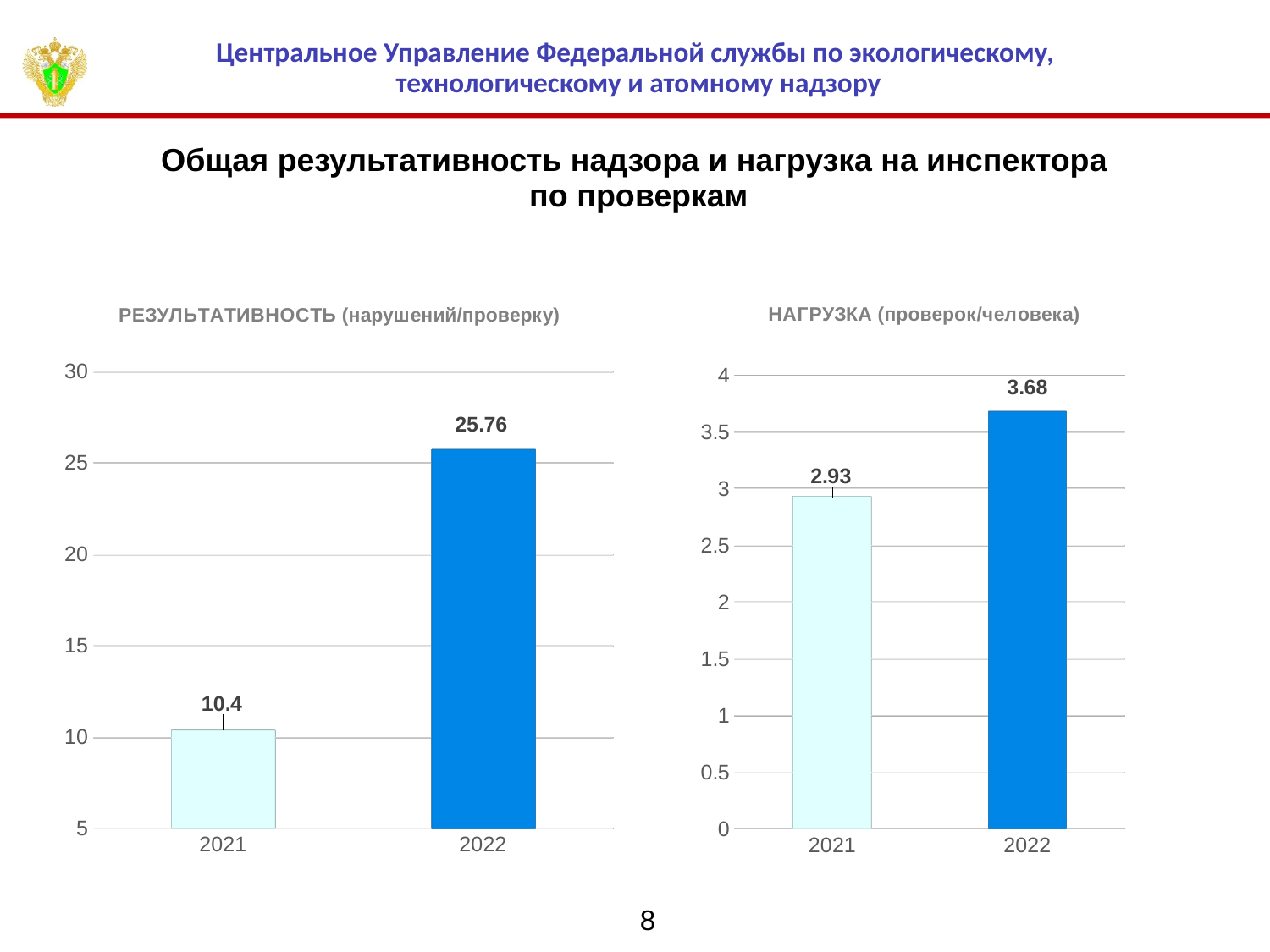
How many categories are shown in the НАГРУЗКА (проверок/человека) chart? 2 In the НАГРУЗКА (проверок/человека) chart, which is larger, the value for 2021 or 2022? 2022 In the РЕЗУЛЬТАТИВНОСТЬ (нарушений/проверку) chart, what is the difference between the 2022 and 2021 values? 15.36 In the НАГРУЗКА (проверок/человека) chart, what is the value for 2021? 2.93 In the НАГРУЗКА (проверок/человека) chart, what is the difference between the 2022 and 2021 values? 0.75 In the РЕЗУЛЬТАТИВНОСТЬ (нарушений/проверку) chart, which year has the highest value? 2022 In the РЕЗУЛЬТАТИВНОСТЬ (нарушений/проверку) chart, is the value for 2022 greater or less than 20? greater In the НАГРУЗКА (проверок/человека) chart, which year has the lowest value? 2021 In the РЕЗУЛЬТАТИВНОСТЬ (нарушений/проверку) chart, what is the value for 2022? 25.76 In the РЕЗУЛЬТАТИВНОСТЬ (нарушений/проверку) chart, what is the value for 2021? 10.4 In the НАГРУЗКА (проверок/человека) chart, what is the value for 2022? 3.68 What type of chart is the РЕЗУЛЬТАТИВНОСТЬ (нарушений/проверку) chart? Bar chart